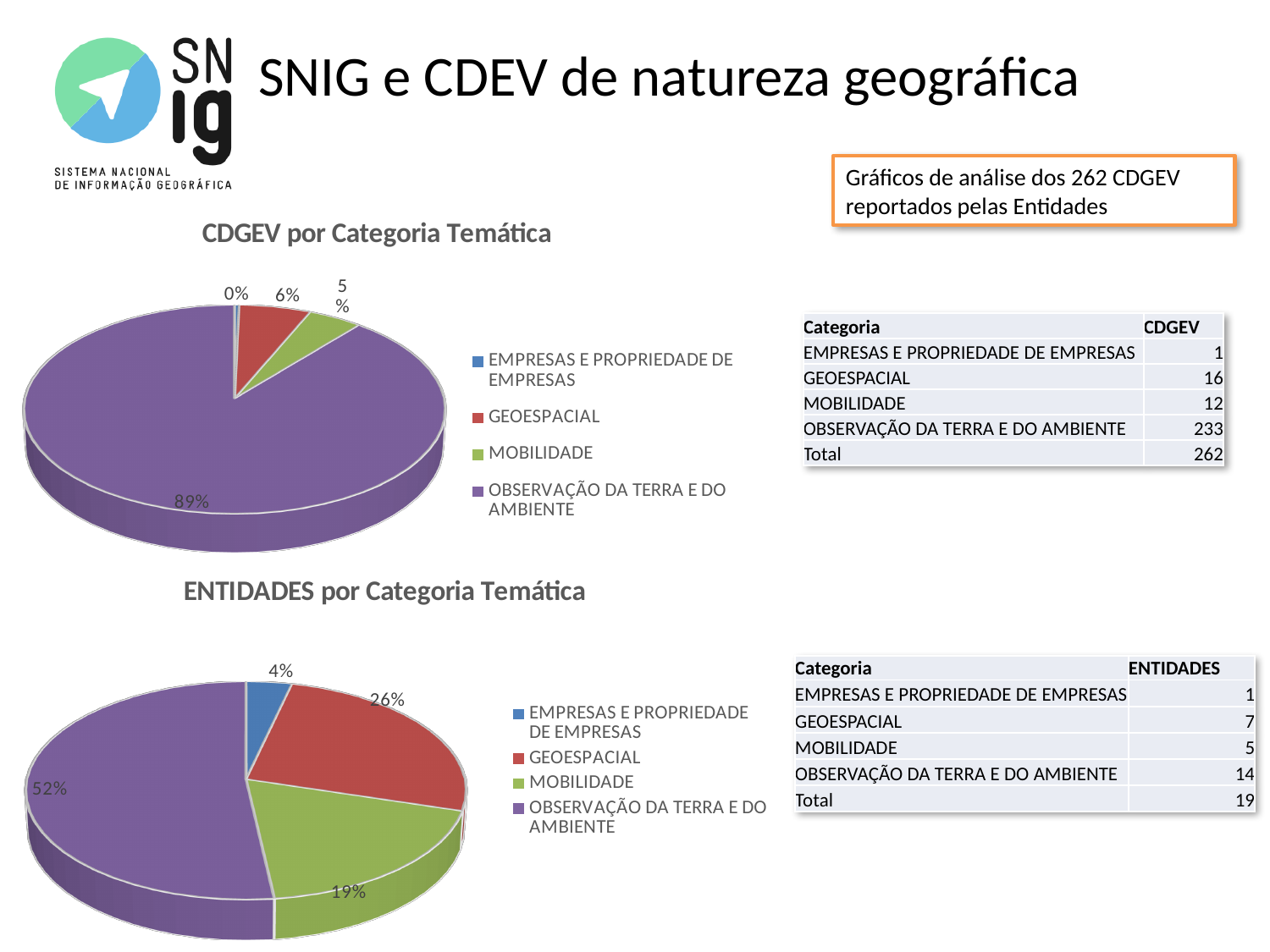
In the 'CDGEV por Categoria Temática' chart, which category has the smallest slice? EMPRESAS E PROPRIEDADE DE EMPRESAS In the 'ENTIDADES por Categoria Temática' chart, what is the difference in percentage points between OBSERVAÇÃO DA TERRA E DO AMBIENTE and GEOESPACIAL? 26 In the 'ENTIDADES por Categoria Temática' chart, what share does MOBILIDADE have? 19% In the 'ENTIDADES por Categoria Temática' chart, what share does GEOESPACIAL have? 26% In the 'CDGEV por Categoria Temática' chart, what share does MOBILIDADE have? 5% In the 'CDGEV por Categoria Temática' chart, which category has the largest slice? OBSERVAÇÃO DA TERRA E DO AMBIENTE In the 'ENTIDADES por Categoria Temática' chart, which is larger, the GEOESPACIAL slice or the MOBILIDADE slice? GEOESPACIAL How many categories does the legend of the 'ENTIDADES por Categoria Temática' chart list? 4 What type of chart is 'CDGEV por Categoria Temática'? pie chart